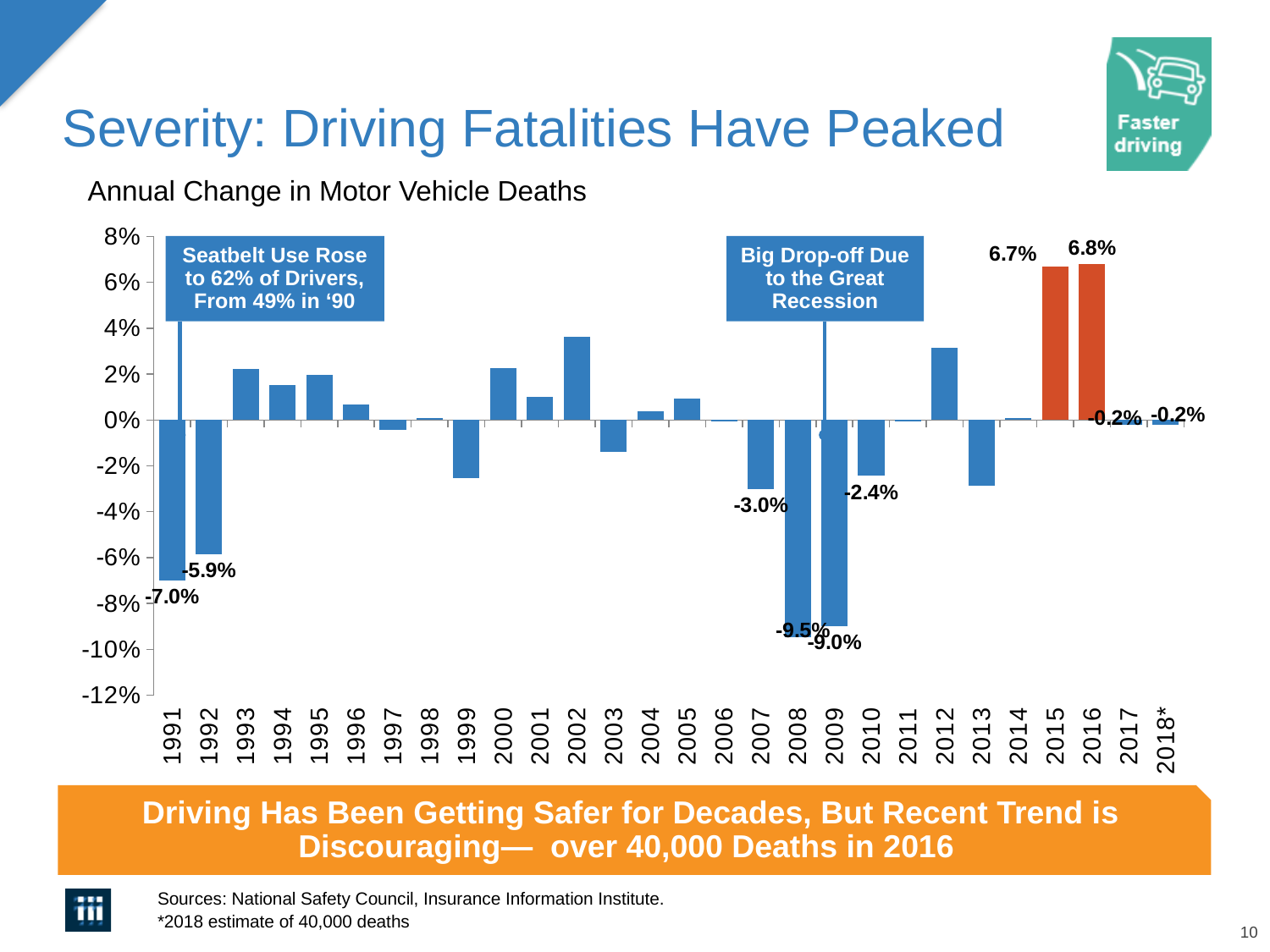
What is the annual change in motor vehicle deaths shown for 1991? -7.0% Which year has the lower value, 1991 or 1992? 1991 What is the difference between the values for 2016 and 2015? 0.1 percentage points Is the value for 2002 greater or less than 2%? greater Is the value for 1999 greater or less than -2%? less Which year has the lowest (most negative) annual change in motor vehicle deaths? 2008 What value is labeled on the bar for 2008? -9.5% How many years are shown on the x axis of the chart? 28 What is the annual change shown for 2016? 6.8% What value is labeled for 2018*? -0.2% What type of chart is used to show the annual change in motor vehicle deaths? Bar chart Which year has the highest annual change in motor vehicle deaths? 2016